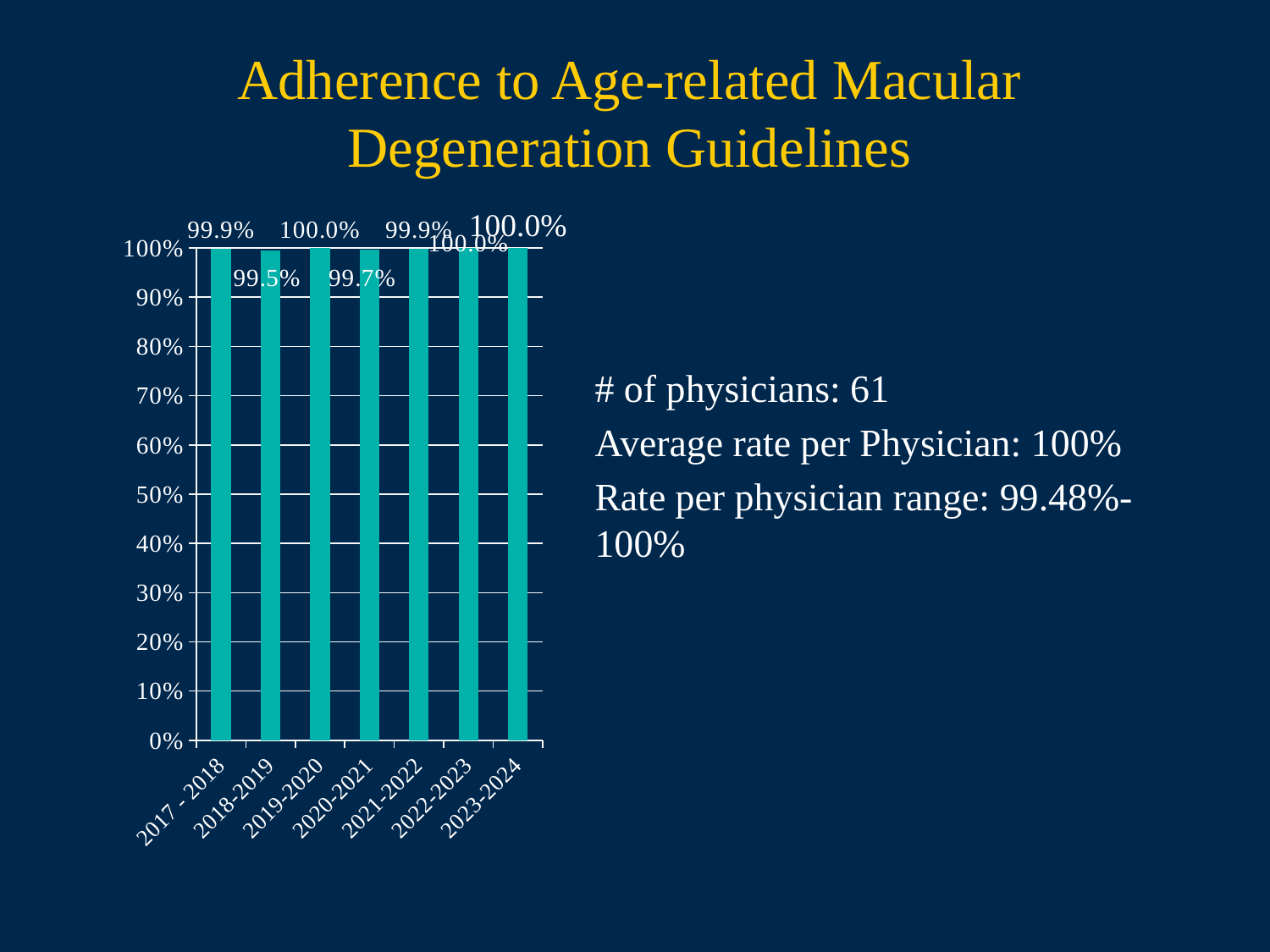
What is the adherence rate for 2020-2021? 99.7% Which time period has the lowest adherence rate? 2018-2019 What is the title of the chart? Adherence to Age-related Macular Degeneration Guidelines What is the adherence rate for 2018-2019? 99.5% Is the value for 2021-2022 greater or less than 90%? greater How many time periods (bars) are shown on the chart? 7 Which has the higher adherence rate, 2018-2019 or 2020-2021? 2020-2021 What is the adherence rate for 2017 - 2018? 99.9% What is the difference between the adherence rate for 2019-2020 and the rate for 2018-2019? 0.5% What is the adherence rate for 2023-2024? 100.0% What type of chart is shown on the slide? Bar chart What is the highest value shown on the vertical axis? 100%